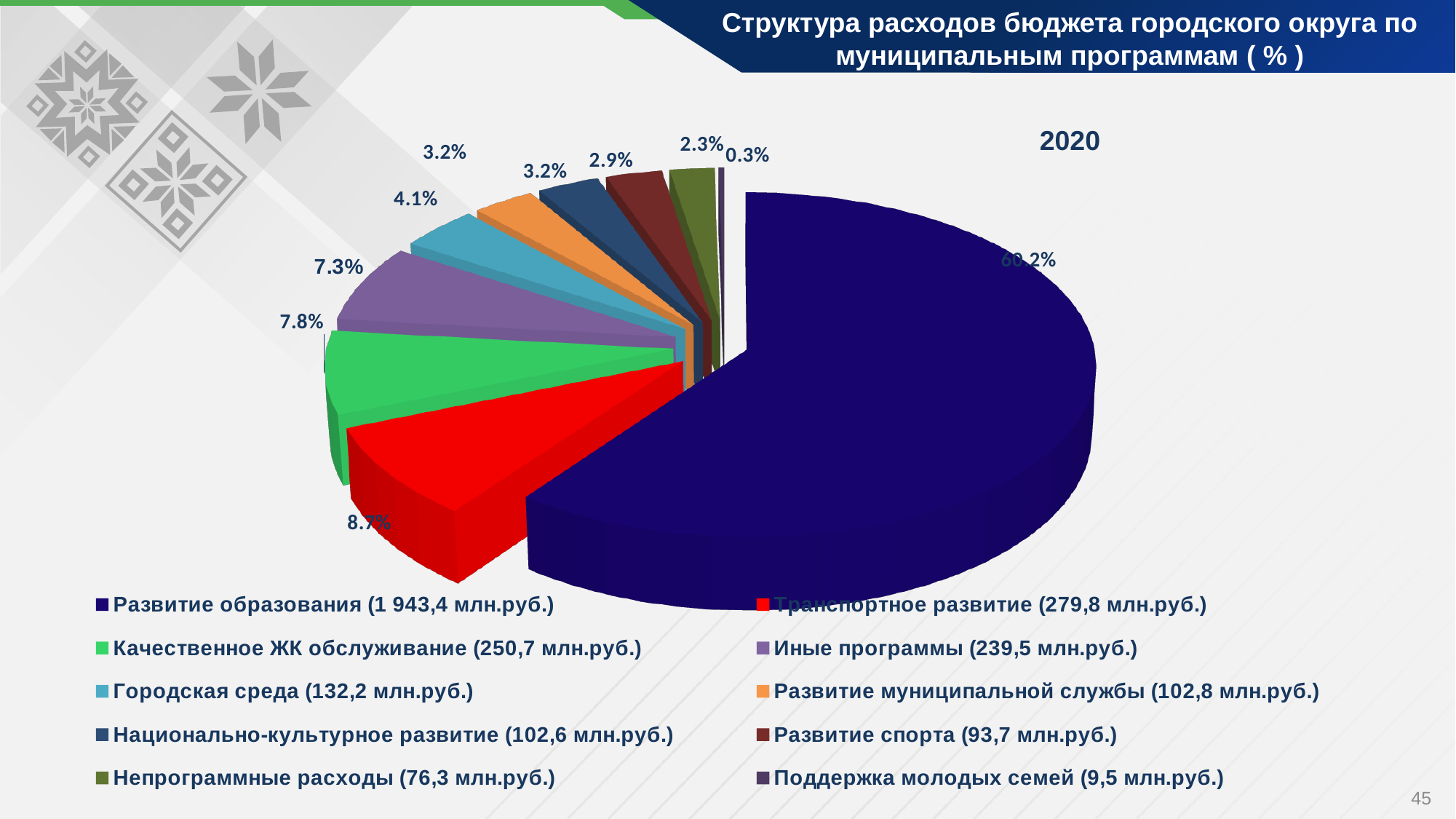
What share of the pie does Городская среда (132,2 млн.руб.) have? 4.1% What share of the pie does Поддержка молодых семей (9,5 млн.руб.) have? 0.3% What is the difference in percentage points between Транспортное развитие (8.7%) and Качественное ЖК обслуживание (7.8%)? 0.9 What share of the pie does Развитие образования (1 943,4 млн.руб.) have? 60.2% Which category has the largest slice of the pie? Развитие образования (1 943,4 млн.руб.) Which year is shown on the chart? 2020 How many categories does the legend list? 10 What share of the pie does Транспортное развитие (279,8 млн.руб.) have? 8.7% Which category has the smallest slice of the pie? Поддержка молодых семей (9,5 млн.руб.) What kind of chart is shown on the slide? pie chart What share of the pie does Качественное ЖК обслуживание (250,7 млн.руб.) have? 7.8% What share of the pie does Иные программы (239,5 млн.руб.) have? 7.3%